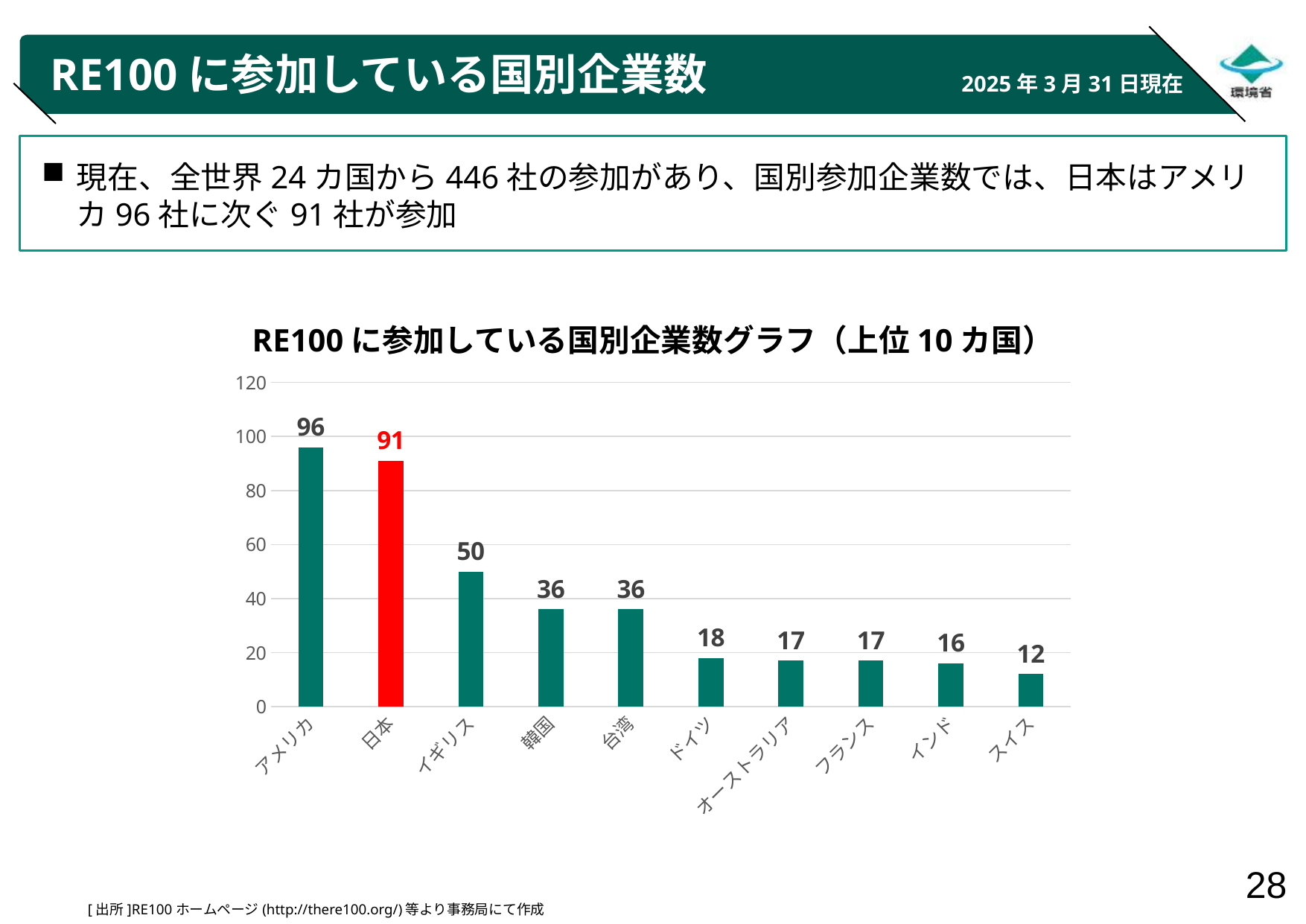
What is the difference between the values for アメリカ and 日本? 5 What kind of chart is shown on the slide? bar chart What is the value for 日本 in the chart? 91 Which country has the highest number of participating companies in the chart? アメリカ How many countries are shown in the chart? 10 Do the values rise or fall from left to right along the x axis? fall Which country has the lowest number of participating companies in the chart? スイス Which country's bar is coloured red in the chart? 日本 Which has a larger value, イギリス or 韓国? イギリス What is the value for スイス in the chart? 12 Is the value for ドイツ greater or less than 20? less What is the value for イギリス in the chart? 50